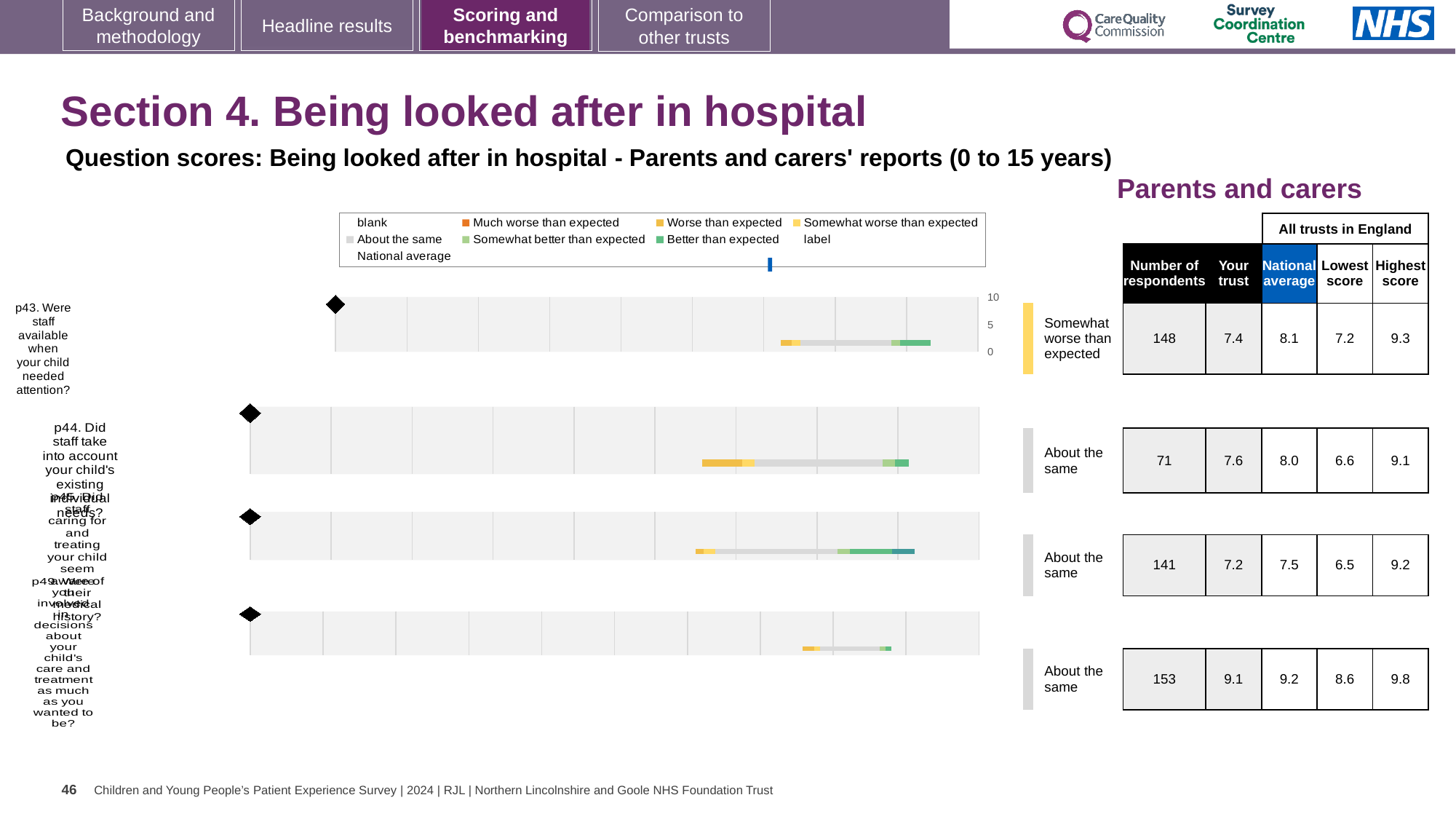
Which benchmark category is the first row (p43) assigned to? Somewhat worse than expected Which row has the highest 'Your trust' score? The fourth row (p49), 9.1 What is the maximum value shown on the score axis of the benchmark charts? 10 Which row has the lowest number of respondents? The second row (p44), 71 Is the 'Your trust' score for the first row (p43) greater or less than 5? greater For the first row (p43), what is the national average score? 8.1 For the first row (p43, Were staff available when your child needed attention?), what is the 'Your trust' score? 7.4 How many survey questions (rows) are plotted in the benchmark charts on this slide? 4 What kind of chart is used to show the question scores on this slide? bar chart For the first row (p43), what is the difference between the national average and the 'Your trust' score? 0.7 For the first row (p43), which is larger: the 'Your trust' score or the national average? National average For the first row (p43), how many respondents are there? 148